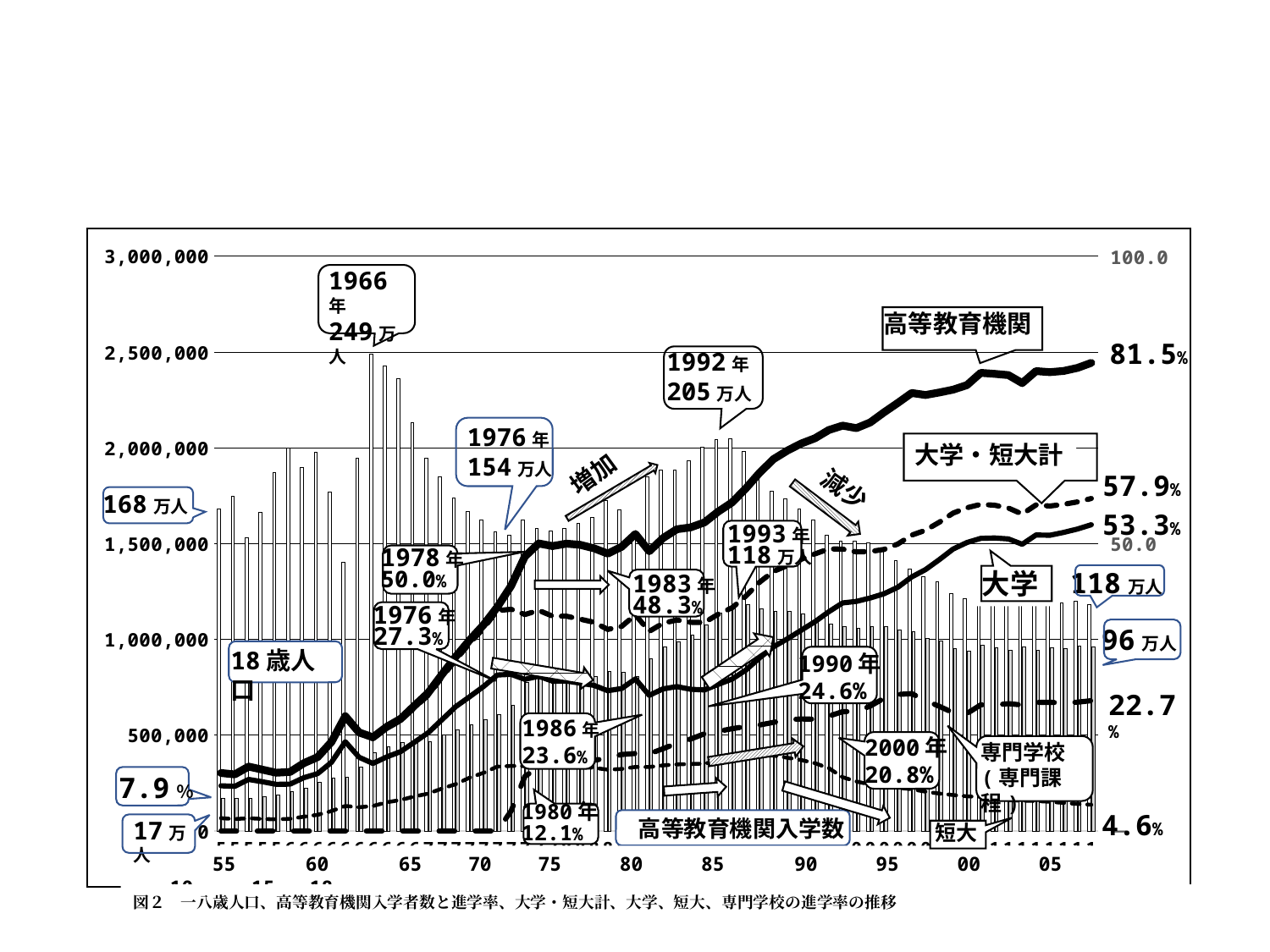
What kind of chart is this? combined bar and line chart What is the difference between the final 高等教育機関 rate (81.5%) and the final 大学・短大計 rate (57.9%)? 23.6% According to the callout, what was the 18歳人口 in 1992年? 205万人 What is the final value shown for the 専門学校（専門課程） line at the right end of the chart? 22.7% Does the 高等教育機関 enrollment rate line generally rise or fall from 55 to 05 along the x axis? rise According to the callout, what was the 18歳人口 in 1966年? 249万人 What is the final value shown for the 短大 line at the right end of the chart? 4.6% What is the final value shown for the 大学・短大計 line at the right end of the chart? 57.9% What is the final value shown for the 大学 line at the right end of the chart? 53.3% What is the final value shown for the 高等教育機関 enrollment rate line at the right end of the chart? 81.5% At the right end of the chart, which is larger: the 大学 rate or the 専門学校 rate? 大学